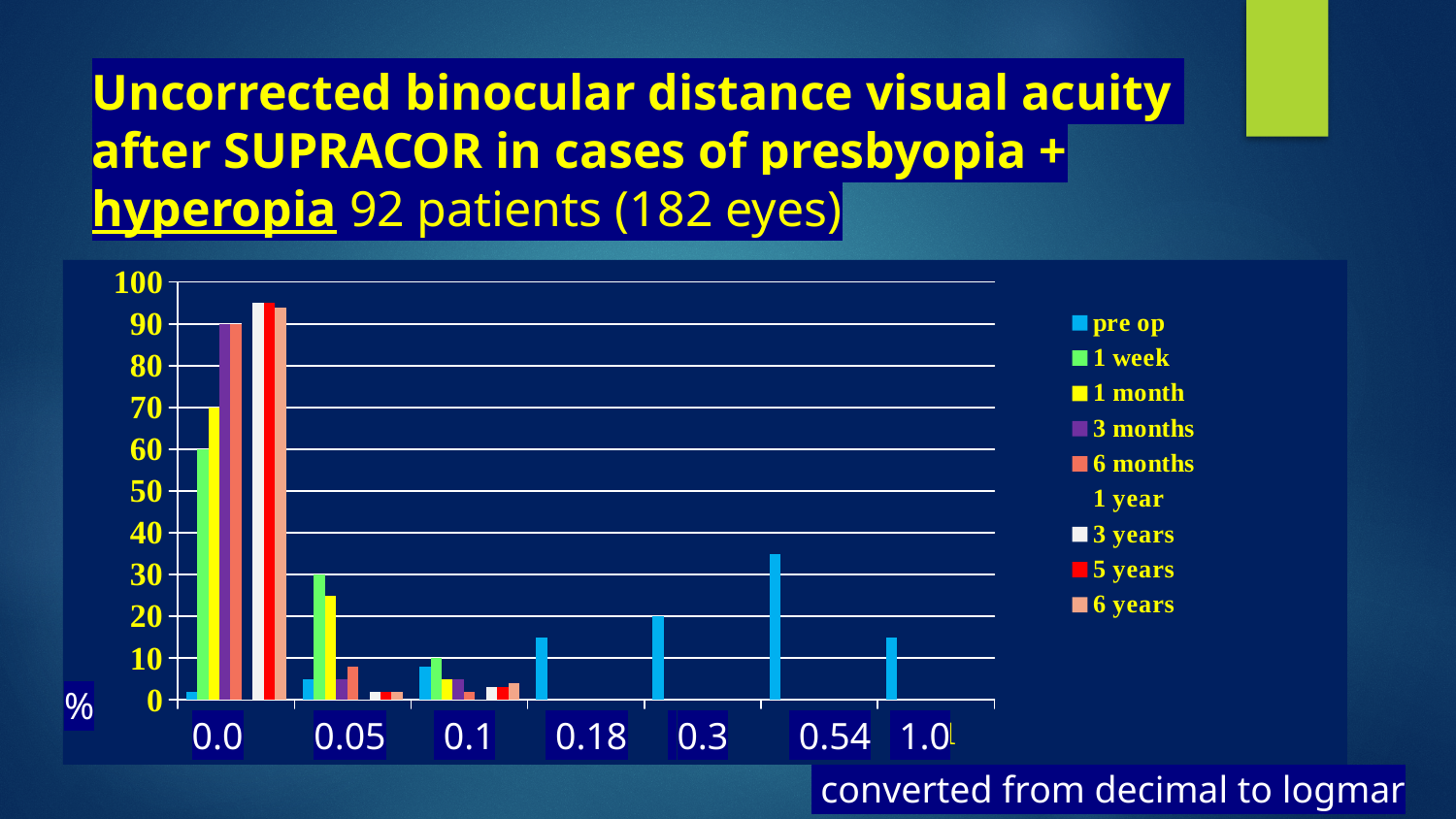
Is the value for the pre op series at 0.3 greater or less than 30? less At 0.0, which is larger: the 1 week value or the 1 month value? 1 month Is the value for the 3 months series at 0.0 greater or less than 80? greater How many series does the chart's legend list? 9 Is the value for the 1 week series at 0.0 greater or less than 50? greater What kind of chart is shown on the slide? bar chart How many categories are shown along the x axis of the chart? 7 What is the first entry listed in the chart's legend? pre op For the pre op series, which is larger: the value at 0.3 or the value at 0.54? 0.54 Does the pre op series rise or fall from 0.18 to 0.54? rise Which x-axis category has the highest pre op value? 0.54